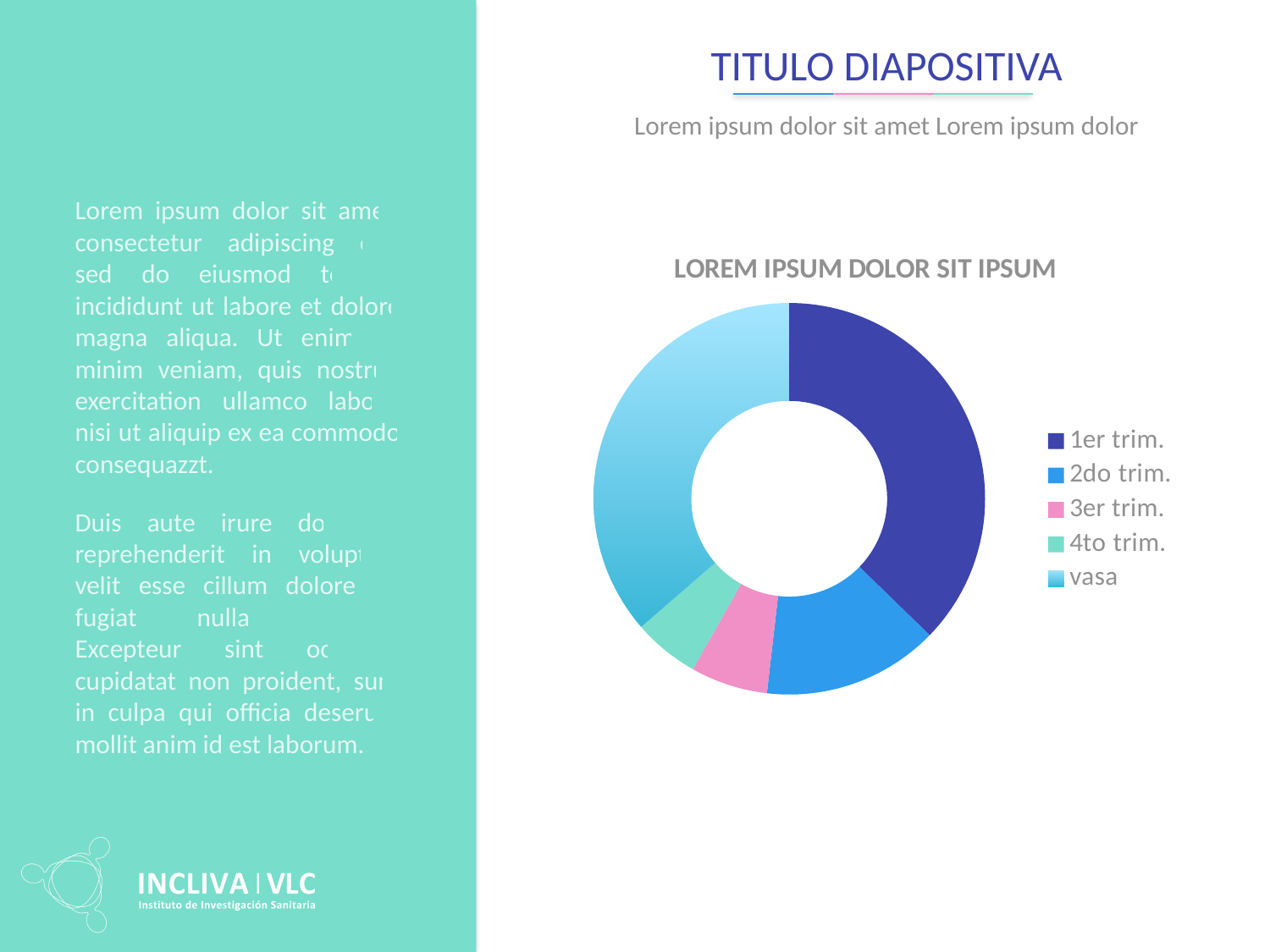
Which slice is larger, 2do trim. or 3er trim.? 2do trim. What kind of chart is shown on the slide? Doughnut (pie) chart Which slice is larger, 2do trim. or 4to trim.? 2do trim. What is the title of the chart? LOREM IPSUM DOLOR SIT IPSUM What is the last entry listed in the chart's legend? vasa Which slice is larger, vasa or 4to trim.? vasa How many categories does the chart's legend list? 5